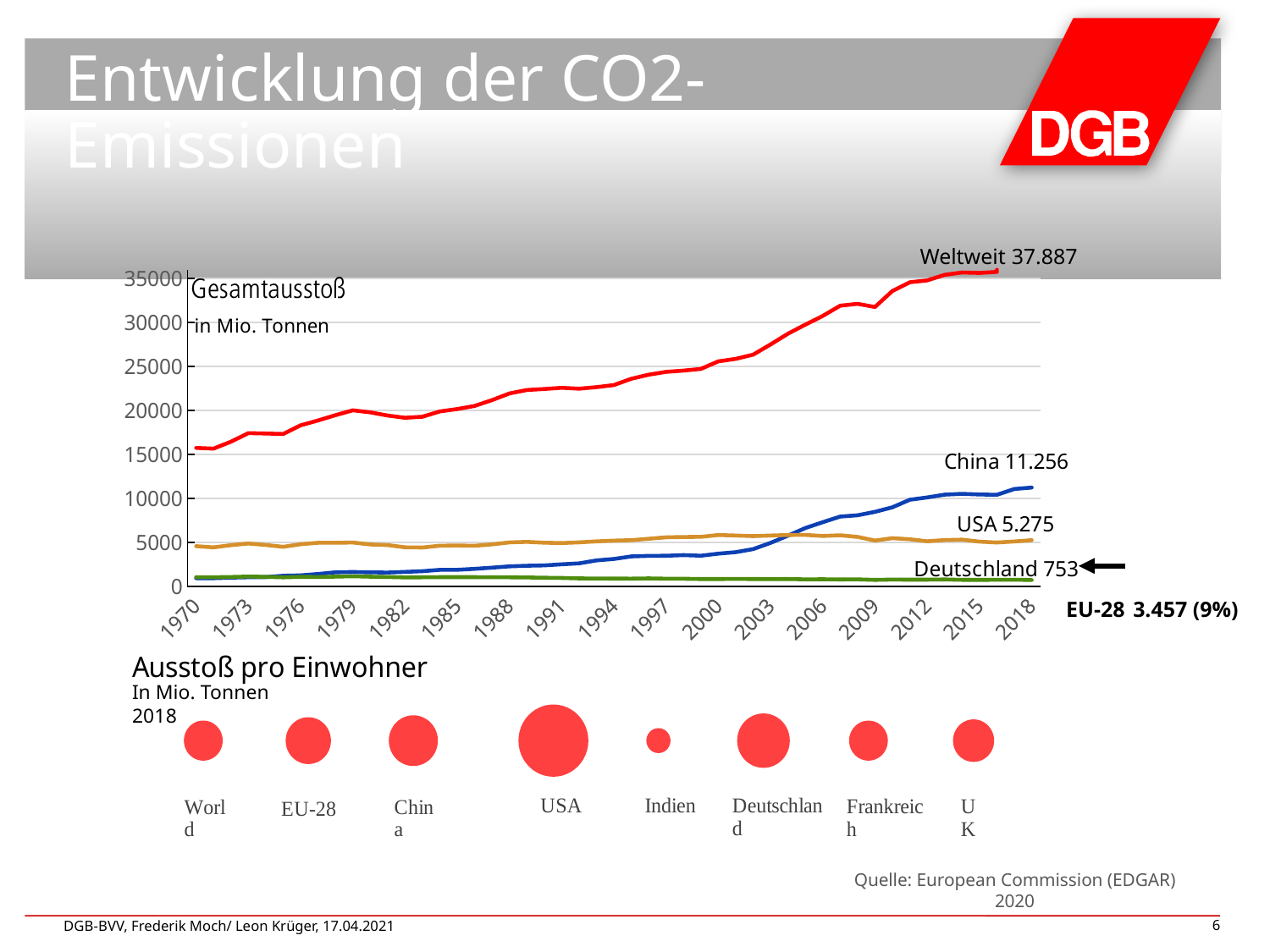
In the line chart 'Gesamtausstoß in Mio. Tonnen', which is larger at the end of the series, China or USA? China In the line chart 'Gesamtausstoß in Mio. Tonnen', what value is labelled for China? 11.256 In the bubble chart 'Ausstoß pro Einwohner', which country has the largest bubble? USA In the bubble chart 'Ausstoß pro Einwohner', how many bubbles are shown? 8 In the line chart 'Gesamtausstoß in Mio. Tonnen', what value is labelled for the USA? 5.275 In the line chart 'Gesamtausstoß in Mio. Tonnen', what value is given for EU-28? 3.457 (9%) What kind of chart is the upper chart 'Gesamtausstoß in Mio. Tonnen'? line chart In the line chart 'Gesamtausstoß in Mio. Tonnen', what value is labelled for Deutschland? 753 In the line chart 'Gesamtausstoß in Mio. Tonnen', what is the difference between the labelled values for China and the USA? 5.981 In the line chart 'Gesamtausstoß in Mio. Tonnen', what value is labelled for Weltweit at the end of the series? 37.887 In the line chart 'Gesamtausstoß in Mio. Tonnen', is the value for China in 2000 greater or less than 5000? less In the line chart 'Gesamtausstoß in Mio. Tonnen', does the Weltweit line rise or fall from 1970 to 2018? rise